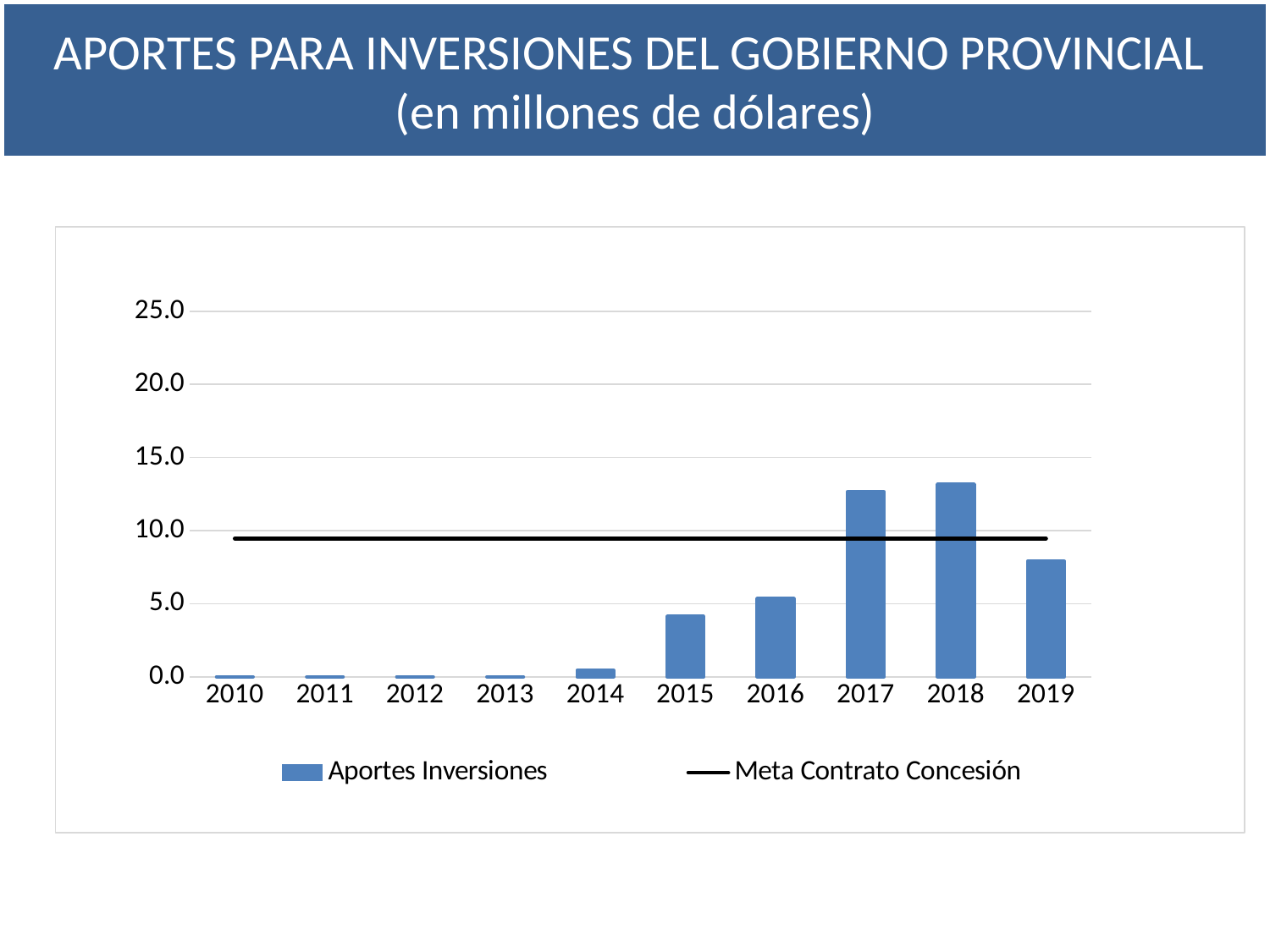
How many years are shown on the x axis of the chart? 10 Is the value for Aportes Inversiones in 2018 greater or less than 15.0? less What unit does the slide title say the values are in? millones de dólares Is the value for Aportes Inversiones in 2017 greater or less than 10.0? greater What is the name of the series drawn as a black horizontal line? Meta Contrato Concesión What kind of chart is shown on the slide? combination bar and line chart Is the value for Aportes Inversiones in 2015 greater or less than 5.0? less Which year has the larger Aportes Inversiones value, 2016 or 2017? 2017 Which year has the larger Aportes Inversiones value, 2019 or 2015? 2019 How many series does the chart's legend list? 2 Do the Aportes Inversiones values rise or fall from 2013 to 2018? rise